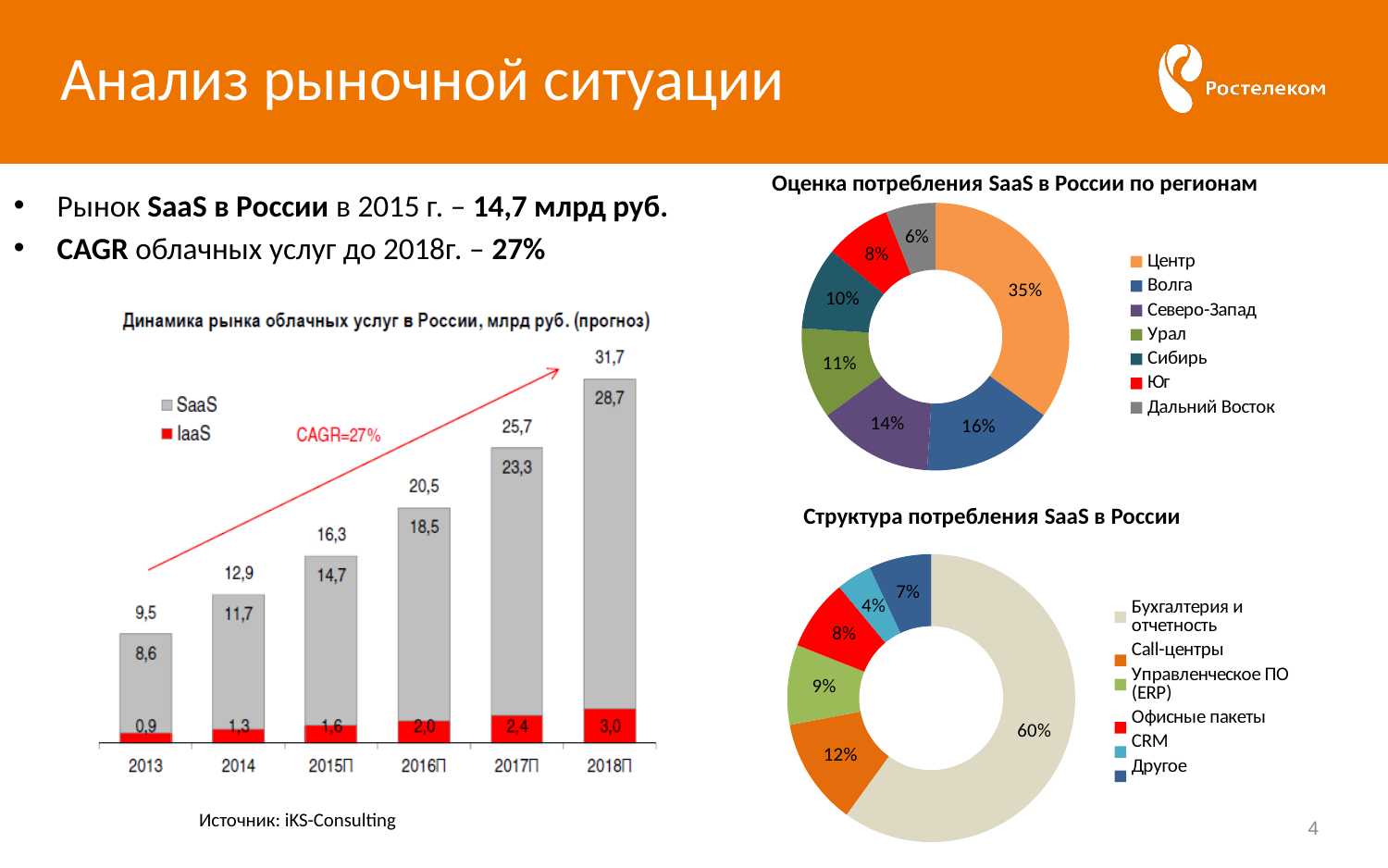
In the chart 'Динамика рынка облачных услуг в России, млрд руб. (прогноз)', what is the SaaS value for 2015П? 14,7 In the chart 'Оценка потребления SaaS в России по регионам', what is the share for Урал? 11% In the chart 'Структура потребления SaaS в России', what is the share for Call-центры? 12% What kind of chart is 'Динамика рынка облачных услуг в России, млрд руб. (прогноз)'? stacked bar chart In the chart 'Оценка потребления SaaS в России по регионам', which region has the largest share? Центр In the chart 'Динамика рынка облачных услуг в России, млрд руб. (прогноз)', do the bar totals rise or fall from 2013 to 2018П? rise In the chart 'Структура потребления SaaS в России', which category has the smallest share? CRM In the chart 'Динамика рынка облачных услуг в России, млрд руб. (прогноз)', what is the IaaS value for 2018П? 3,0 In the chart 'Оценка потребления SaaS в России по регионам', how many regions are shown? 7 In the chart 'Динамика рынка облачных услуг в России, млрд руб. (прогноз)', what is the difference between the SaaS values for 2018П and 2013? 20,1 In the chart 'Динамика рынка облачных услуг в России, млрд руб. (прогноз)', what is the total of the stacked bar for 2017П? 25,7 In the chart 'Динамика рынка облачных услуг в России, млрд руб. (прогноз)', how many series does the legend list? 2